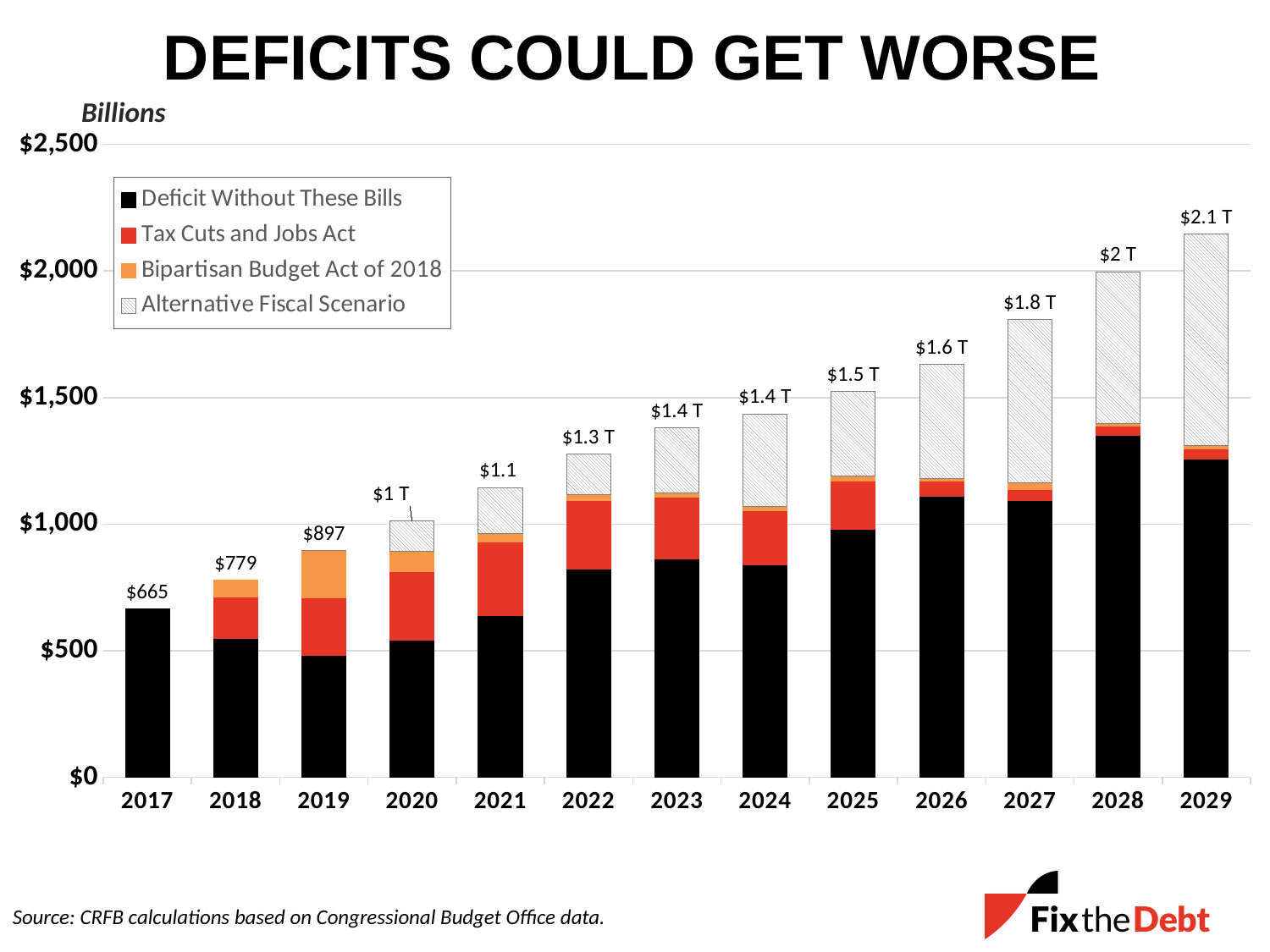
What kind of chart is shown on the slide? Stacked bar chart Which year has the lowest total deficit shown? 2017 How many series does the legend list? 4 Which year has a larger labeled total, 2026 or 2027? 2027 What is the total deficit labeled for 2019? $897 What is the difference between the labeled totals for 2018 and 2017? $114 How many years are shown on the x axis? 13 What is the total deficit labeled for 2029? $2.1 T Which year has the highest total deficit shown? 2029 What is the total deficit labeled for 2017? $665 Is the Deficit Without These Bills value for 2029 greater or less than $1,000? greater Do the total deficits generally rise or fall from 2017 to 2029? Rise